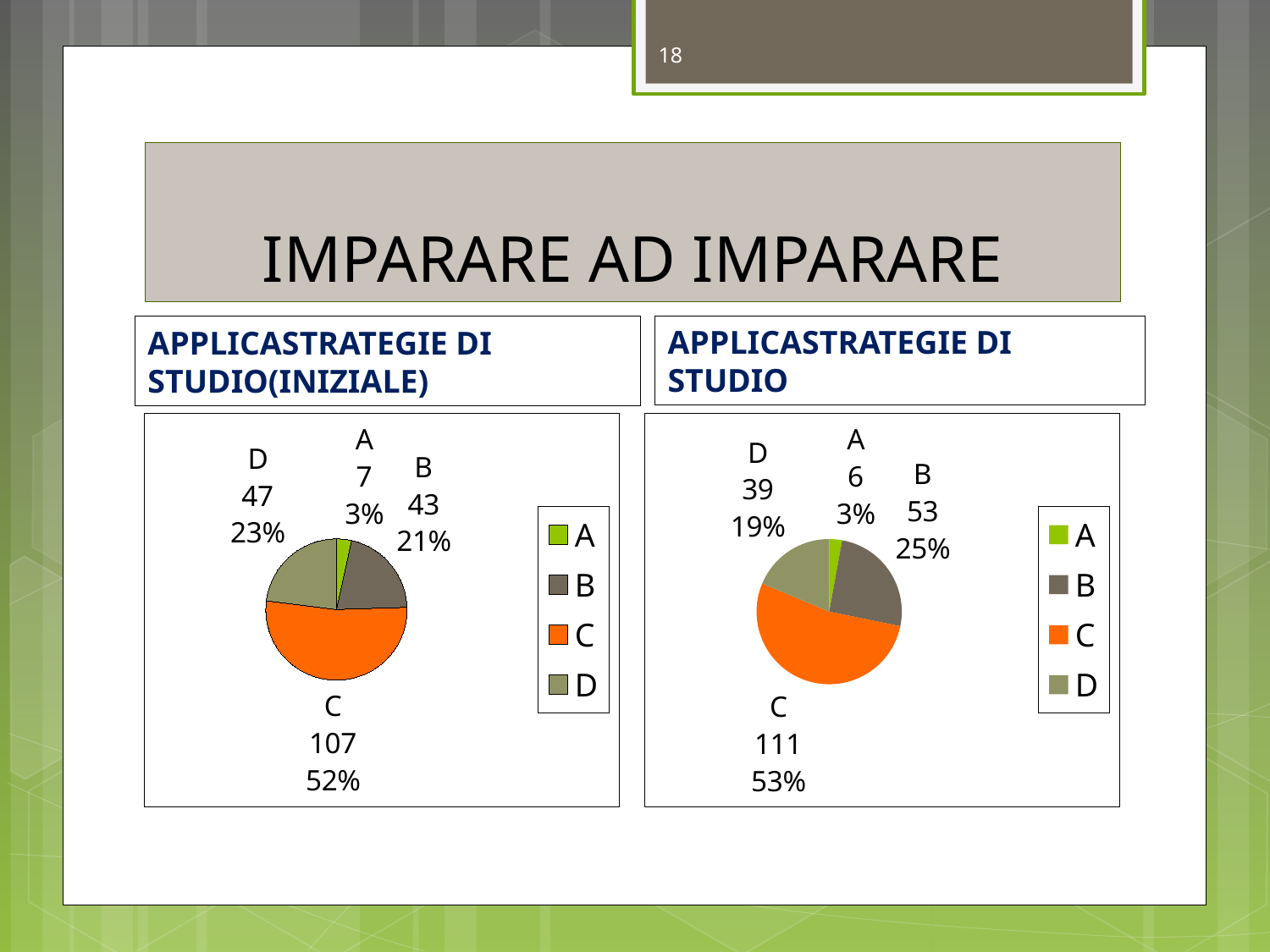
In the right chart (APPLICASTRATEGIE DI STUDIO), what is the value for category B? 53 What kind of chart is the right chart (APPLICASTRATEGIE DI STUDIO)? Pie chart In the left chart (APPLICASTRATEGIE DI STUDIO(INIZIALE)), what share of the pie does category D represent? 23% In the right chart (APPLICASTRATEGIE DI STUDIO), what is the difference between the values for B and D? 14 How many categories does the left chart (APPLICASTRATEGIE DI STUDIO(INIZIALE)) show? 4 In the right chart (APPLICASTRATEGIE DI STUDIO), which category has the smallest slice? A In the left chart (APPLICASTRATEGIE DI STUDIO(INIZIALE)), what is the value for category C? 107 In the left chart (APPLICASTRATEGIE DI STUDIO(INIZIALE)), what is the difference between the values for C and D? 60 In the left chart (APPLICASTRATEGIE DI STUDIO(INIZIALE)), what colour is the slice for category C? Orange In the left chart (APPLICASTRATEGIE DI STUDIO(INIZIALE)), which category has the largest slice? C In the right chart (APPLICASTRATEGIE DI STUDIO), what share of the pie does category C represent? 53% In the right chart (APPLICASTRATEGIE DI STUDIO), which is larger, the value for B or the value for D? B